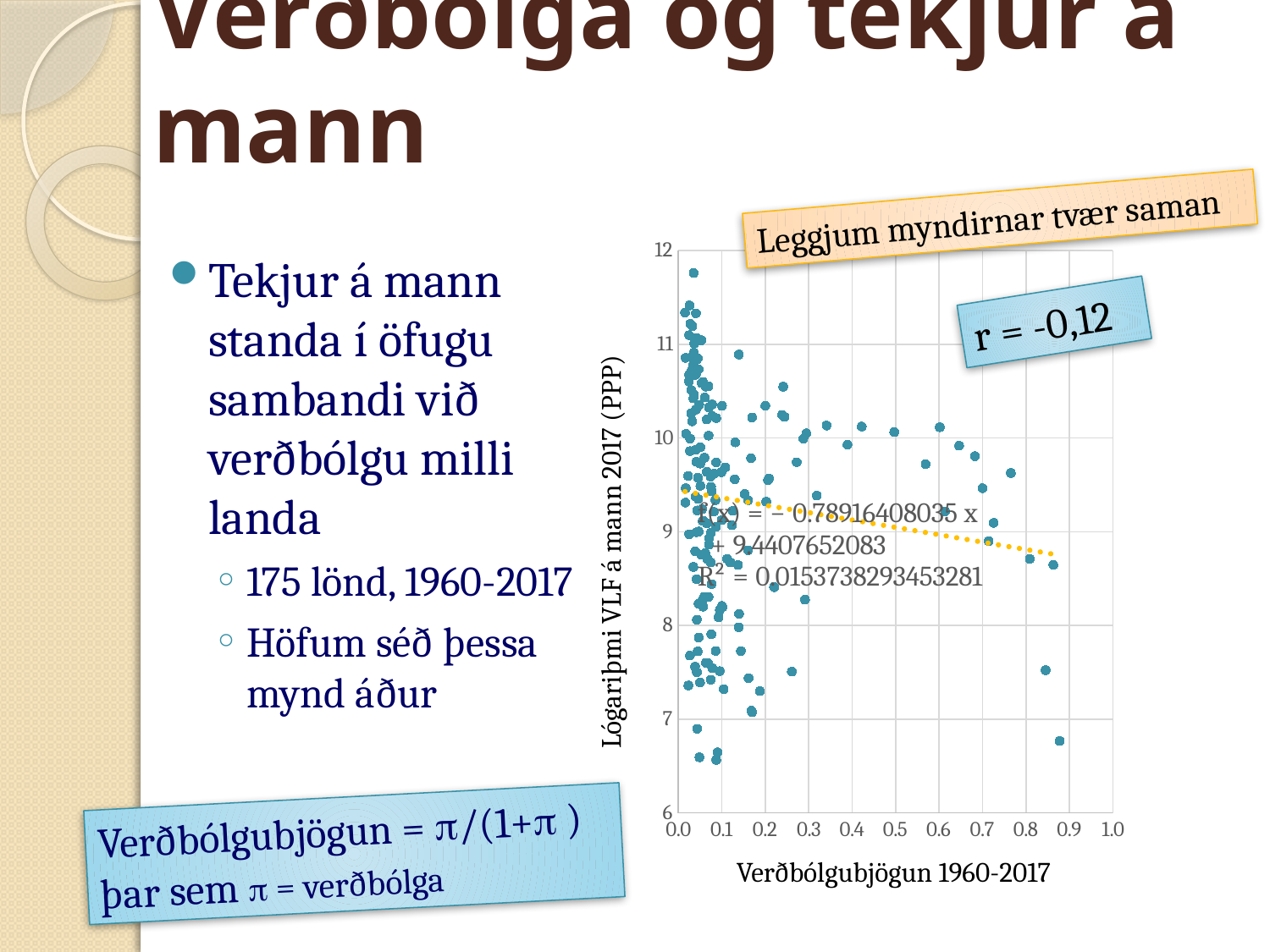
What is the title of the x axis of the chart? Verðbólgubjögun 1960-2017 What is the intercept of the trendline equation shown on the chart? 9.4407652083 Is the y value of the highest point on the chart greater or less than 11? greater What is the title of the y axis of the chart? Lógariþmi VLF á mann 2017 (PPP) What correlation coefficient r is shown next to the chart? r = -0,12 How many countries are plotted in the chart, according to the slide? 175 Is the y value of the lowest point near x = 0.9 greater or less than 7? less What is the maximum value shown on the y axis of the chart? 12 What is the slope of the trendline equation shown on the chart? −0.78916408035 Does the trendline rise or fall as Verðbólgubjögun increases along the x axis? Fall What R² value is printed on the chart? 0.0153738293453281 What kind of chart is shown on the slide? Scatter chart